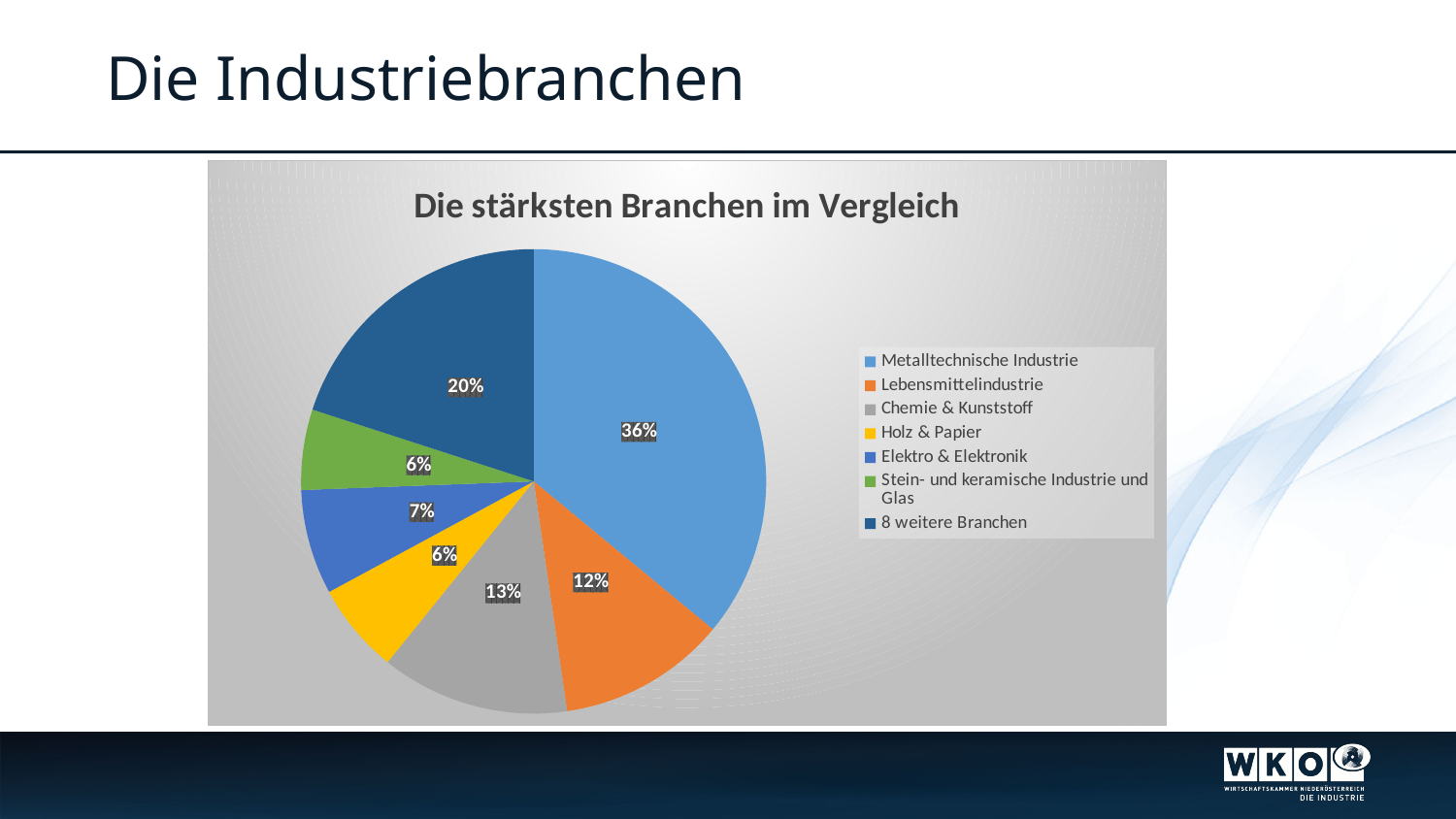
What colour is the slice for Holz & Papier? yellow What share of the pie does Chemie & Kunststoff have? 13% What share of the pie does Elektro & Elektronik have? 7% How many slices does the pie chart have? 7 Which category has the largest slice of the pie? Metalltechnische Industrie What kind of chart is shown on the slide? pie chart What share of the pie does 8 weitere Branchen have? 20% Which is larger, the share of Chemie & Kunststoff or the share of Lebensmittelindustrie? Chemie & Kunststoff What share of the pie does Lebensmittelindustrie have? 12% What is the title of the chart? Die stärksten Branchen im Vergleich What share of the pie does Metalltechnische Industrie have? 36% What is the difference between the shares of Metalltechnische Industrie and 8 weitere Branchen? 16%